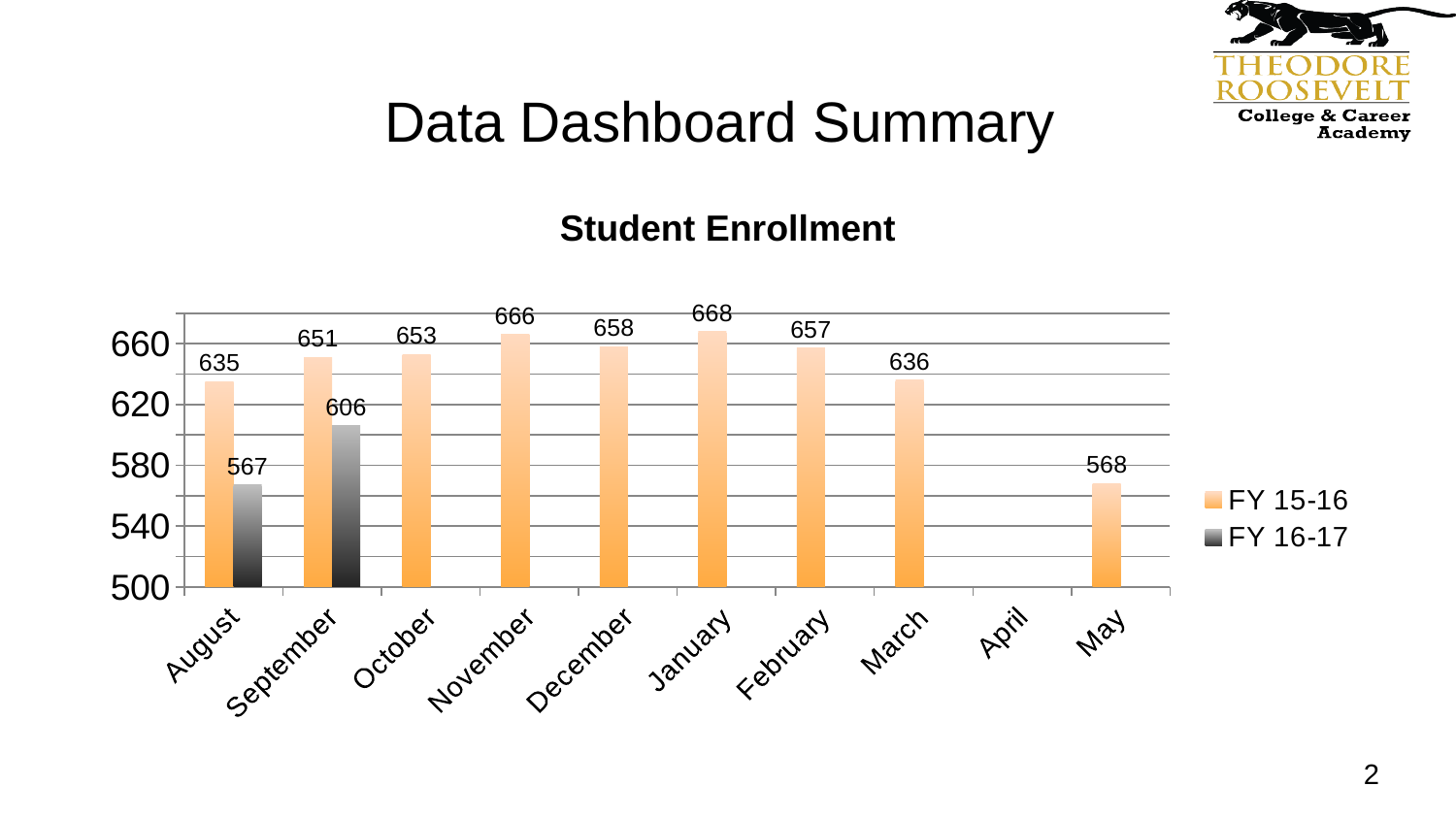
Which month has the highest FY 15-16 enrollment? January What is the FY 15-16 student enrollment value for May? 568 Is the FY 16-17 enrollment value for August greater or less than 580? less What is the FY 15-16 student enrollment value for November? 666 What is the difference between the FY 15-16 and FY 16-17 enrollment values for August? 68 How many series does the legend list? 2 Which month has the lowest FY 15-16 enrollment? May What kind of chart is used to show Student Enrollment? Bar chart Which is larger, the FY 15-16 enrollment for October or for March? October How many months are shown on the x axis of the chart? 10 What is the FY 16-17 student enrollment value for September? 606 What is the difference between the FY 15-16 and FY 16-17 enrollment values for September? 45